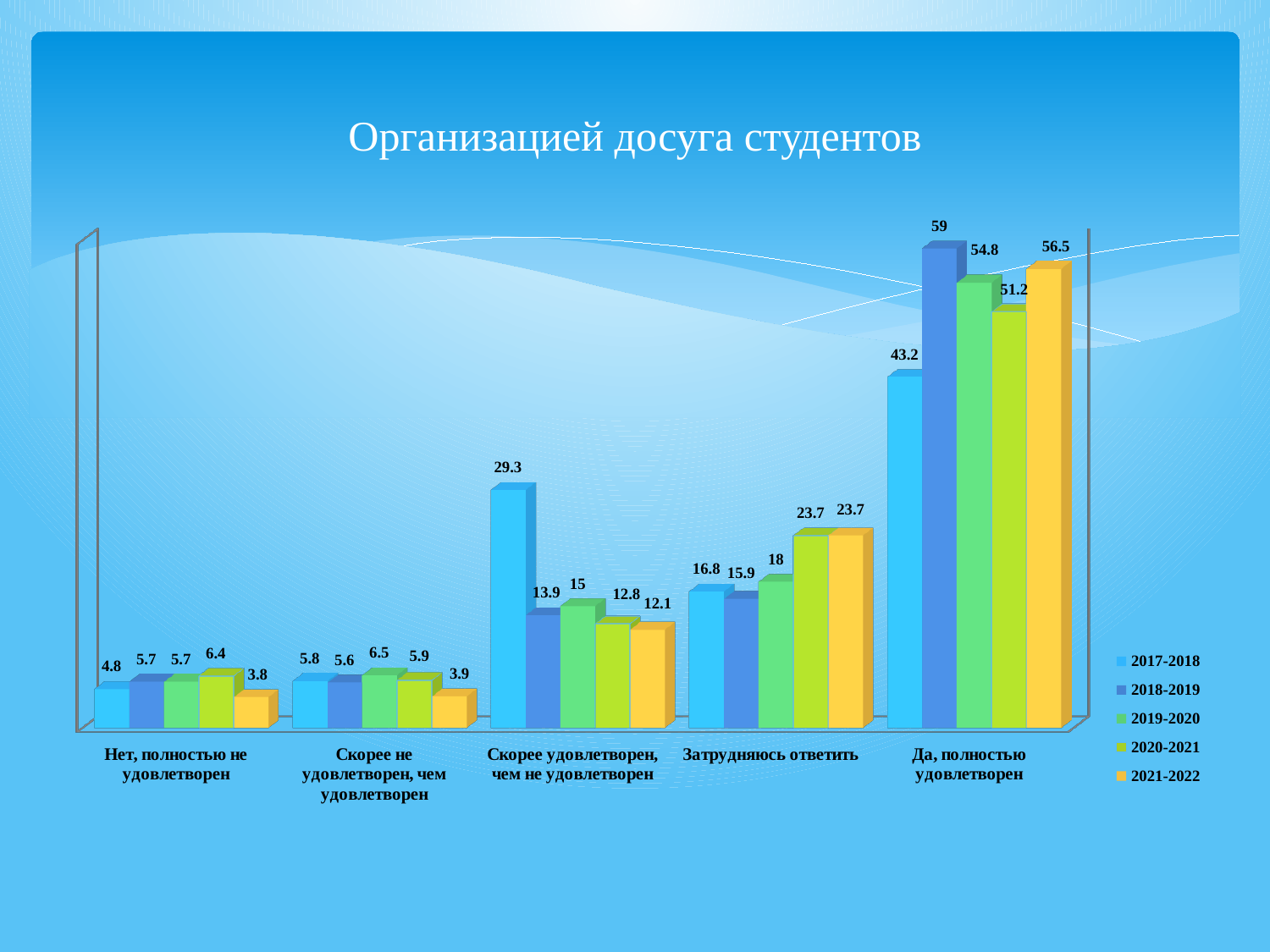
What is the value for 2021-2022 in the category "Да, полностью удовлетворен"? 56.5 What is the value for 2017-2018 in the category "Скорее удовлетворен, чем не удовлетворен"? 29.3 In the category "Затрудняюсь ответить", which is larger: the value for 2019-2020 or the value for 2018-2019? 2019-2020 What is the value for 2020-2021 in the category "Нет, полностью не удовлетворен"? 6.4 How many series does the legend list? 5 What is the difference between the 2017-2018 and 2018-2019 values in the category "Скорее удовлетворен, чем не удовлетворен"? 15.4 What is the title of the chart? Организацией досуга студентов How many categories are shown on the x axis? 5 What kind of chart is shown on the slide? Bar chart Which series has the lowest value in the category "Скорее не удовлетворен, чем удовлетворен"? 2021-2022 What is the difference between the 2018-2019 and 2017-2018 values in the category "Да, полностью удовлетворен"? 15.8 Which series has the highest value in the category "Да, полностью удовлетворен"? 2018-2019